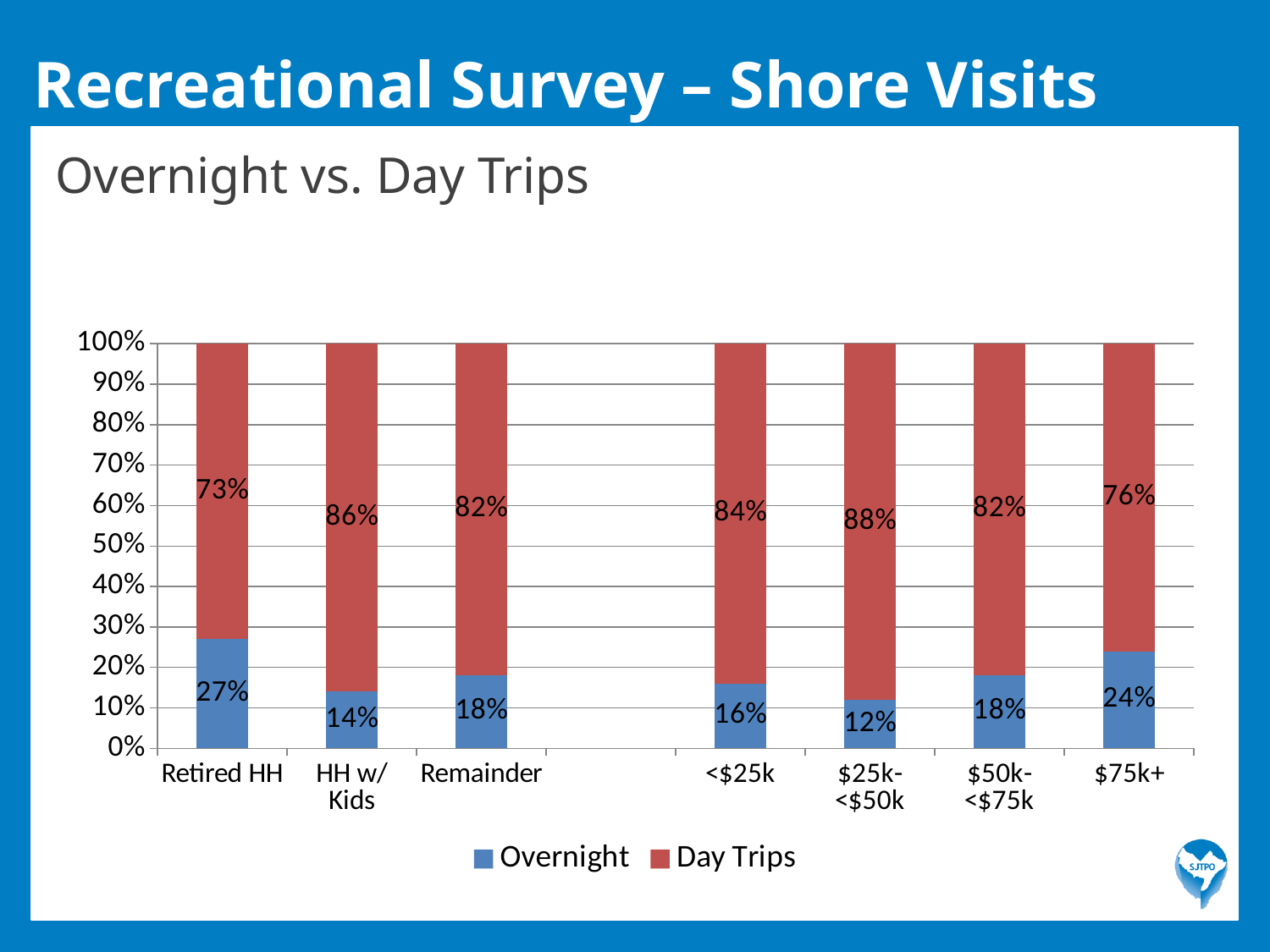
What is the difference between the Day Trips values for $25k-<$50k and Retired HH? 15% What is the Day Trips value for HH w/ Kids? 86% How many series does the legend list? 2 Which category has the lowest Overnight value? $25k-<$50k Which is larger, the Overnight value for Remainder or the Overnight value for <$25k? Remainder How many categories are shown on the x axis? 7 What is the Day Trips value for $25k-<$50k? 88% What is the Overnight value for Retired HH? 27% Is the Day Trips value for $75k+ greater or less than 70%? greater What is the Overnight value for $75k+? 24% What kind of chart is shown on the slide? stacked bar chart Which category has the highest Overnight value? Retired HH